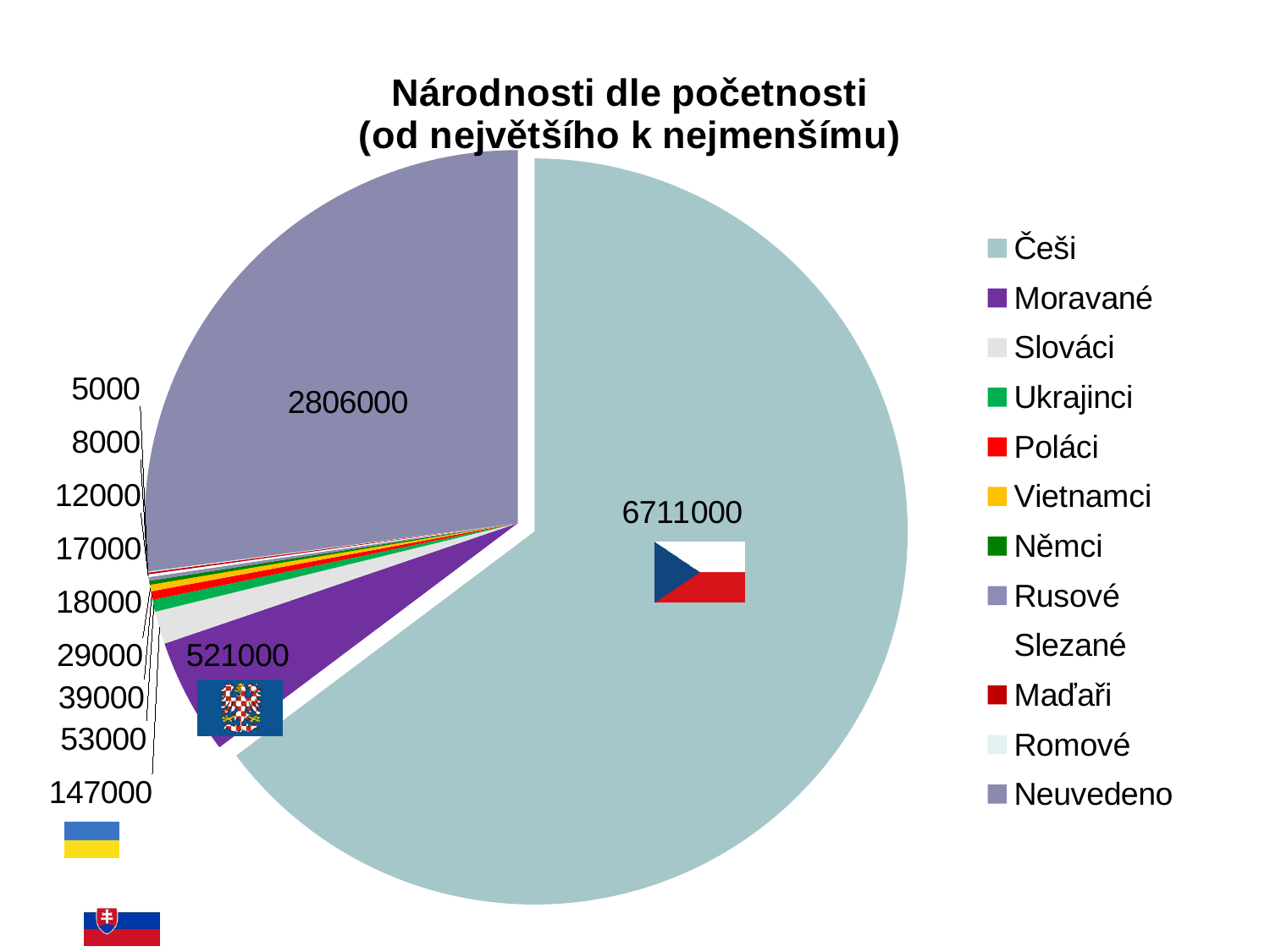
Which is larger, the value for Moravané or the value for Neuvedeno? Neuvedeno How many data series does the chart have? 1 Which category has the largest slice of the pie? Češi What kind of chart is shown on the slide? pie chart What is the value shown for Češi? 6711000 What is the value shown for Slováci? 147000 What is the value shown for Neuvedeno? 2806000 How many categories does the legend list? 12 Which category has the smallest slice of the pie? Romové What is the value shown for Moravané? 521000 What is the title of the chart? Národnosti dle početnosti (od největšího k nejmenšímu) What is the difference between the values for Češi and Neuvedeno? 3905000